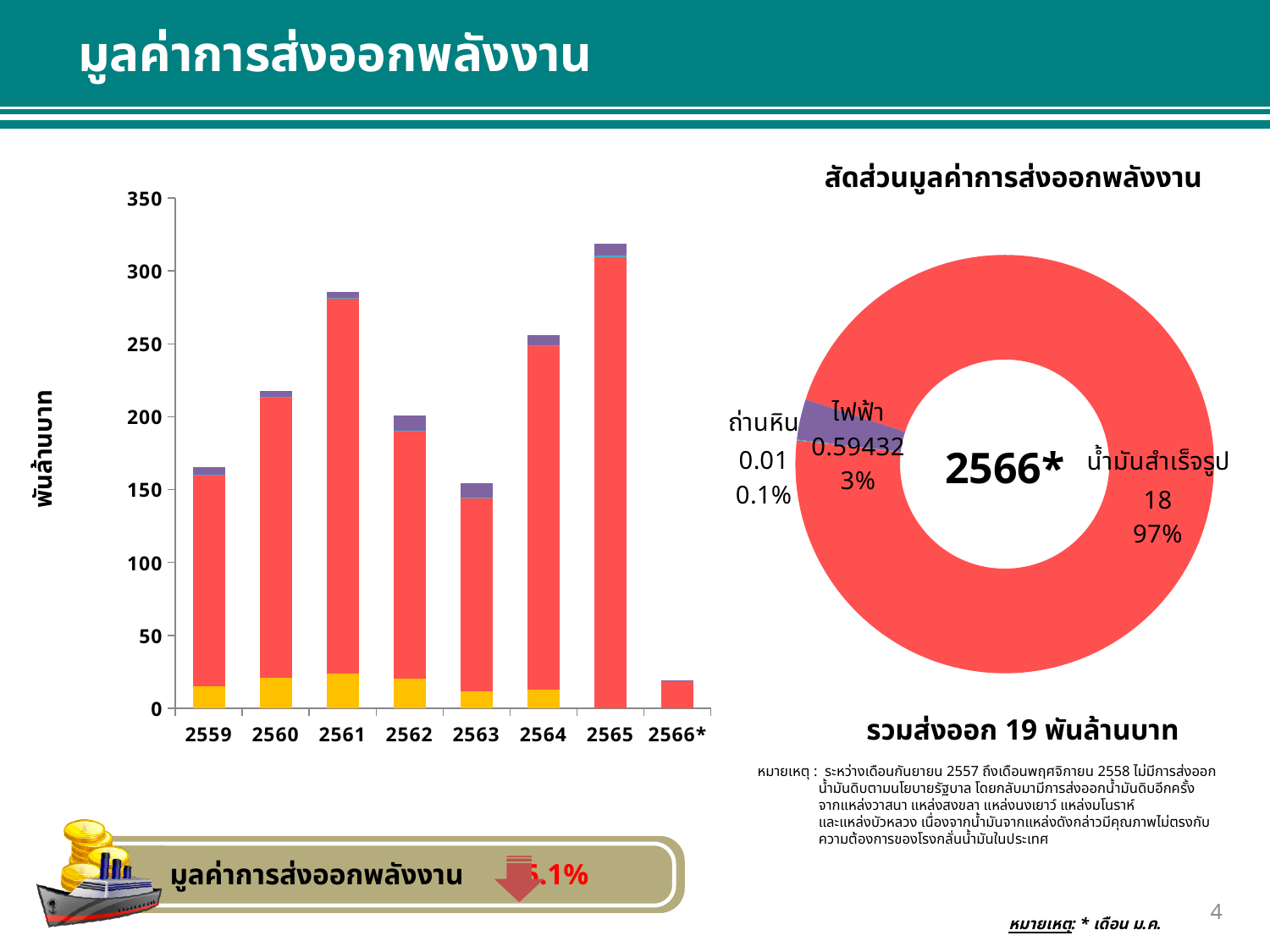
In the bar chart on the left, is the total for 2561 greater or less than 250? greater In the bar chart on the left, which year has the tallest bar? 2565 In the bar chart on the left, is the total for 2565 greater or less than 300? greater What kind of chart is the chart titled สัดส่วนมูลค่าการส่งออกพลังงาน? doughnut chart In the bar chart on the left, which year has the shortest bar? 2566* In the bar chart on the left, how many years are shown on the x axis? 8 In the doughnut chart titled สัดส่วนมูลค่าการส่งออกพลังงาน, what share does ไฟฟ้า have? 3% In the doughnut chart titled สัดส่วนมูลค่าการส่งออกพลังงาน, what is the value for น้ำมันสำเร็จรูป? 18 In the doughnut chart titled สัดส่วนมูลค่าการส่งออกพลังงาน, which category has the smallest share? ถ่านหิน In the bar chart on the left, which bar is taller, 2561 or 2564? 2561 In the bar chart on the left, is the total for 2566* greater or less than 50? less What kind of chart is the chart on the left of the slide? bar chart